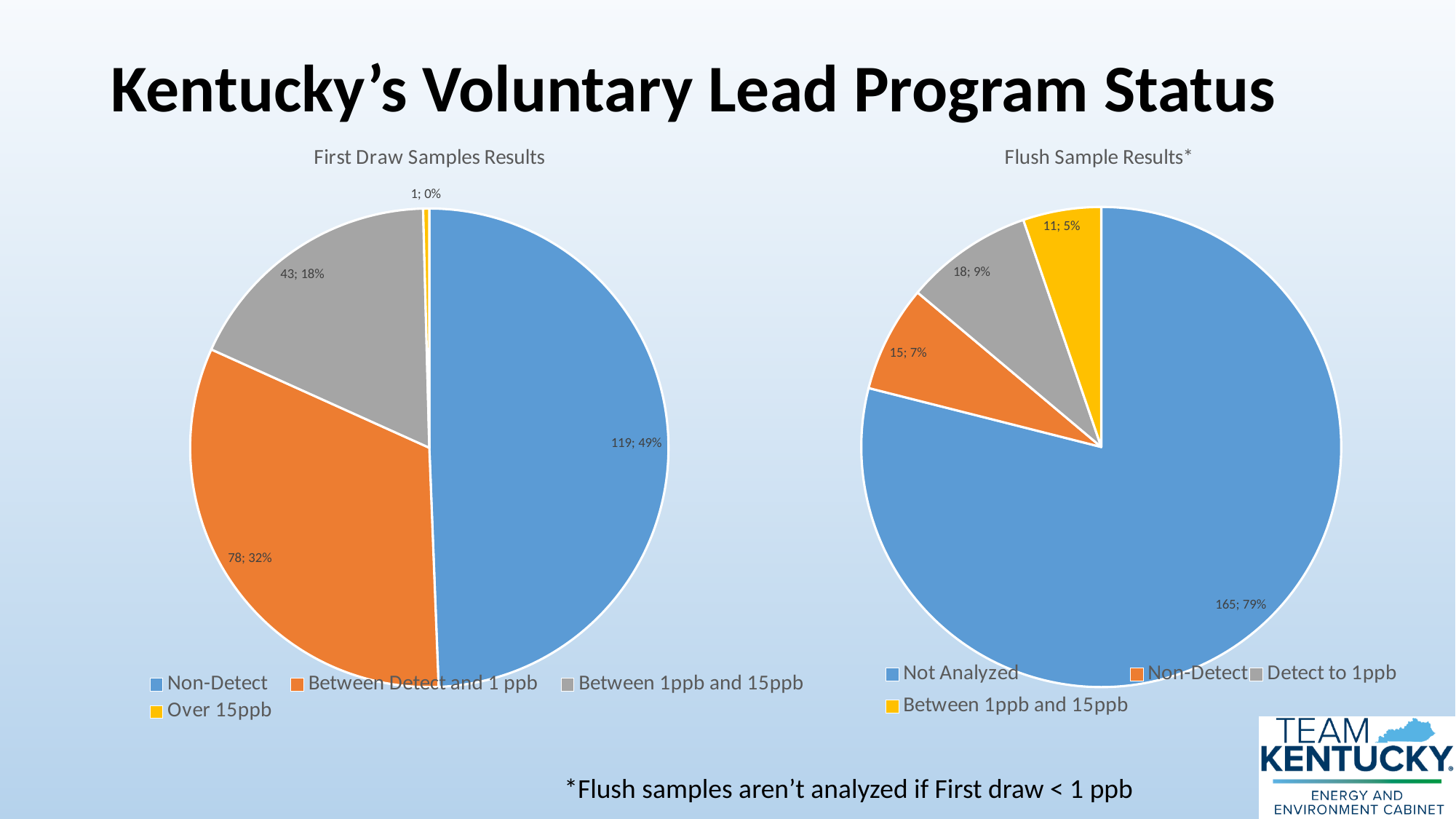
In the First Draw Samples Results chart, which category has the smallest slice? Over 15ppb In the Flush Sample Results chart, what share of samples were Detect to 1ppb? 9% In the First Draw Samples Results chart, what share of samples were Between Detect and 1 ppb? 32% In the Flush Sample Results chart, which category has the largest slice? Not Analyzed In the First Draw Samples Results chart, how many samples were Non-Detect? 119 What type of chart is used for the Flush Sample Results? Pie chart In the Flush Sample Results chart, what is the difference between the Non-Detect count and the Between 1ppb and 15ppb count? 4 In the Flush Sample Results chart, which is larger: Non-Detect or Detect to 1ppb? Detect to 1ppb In the Flush Sample Results chart, how many samples were Not Analyzed? 165 In the Flush Sample Results chart, what colour is the Between 1ppb and 15ppb slice? Yellow In the First Draw Samples Results chart, what is the difference between the Non-Detect count and the Between 1ppb and 15ppb count? 76 In the First Draw Samples Results chart, how many categories does the legend list? 4